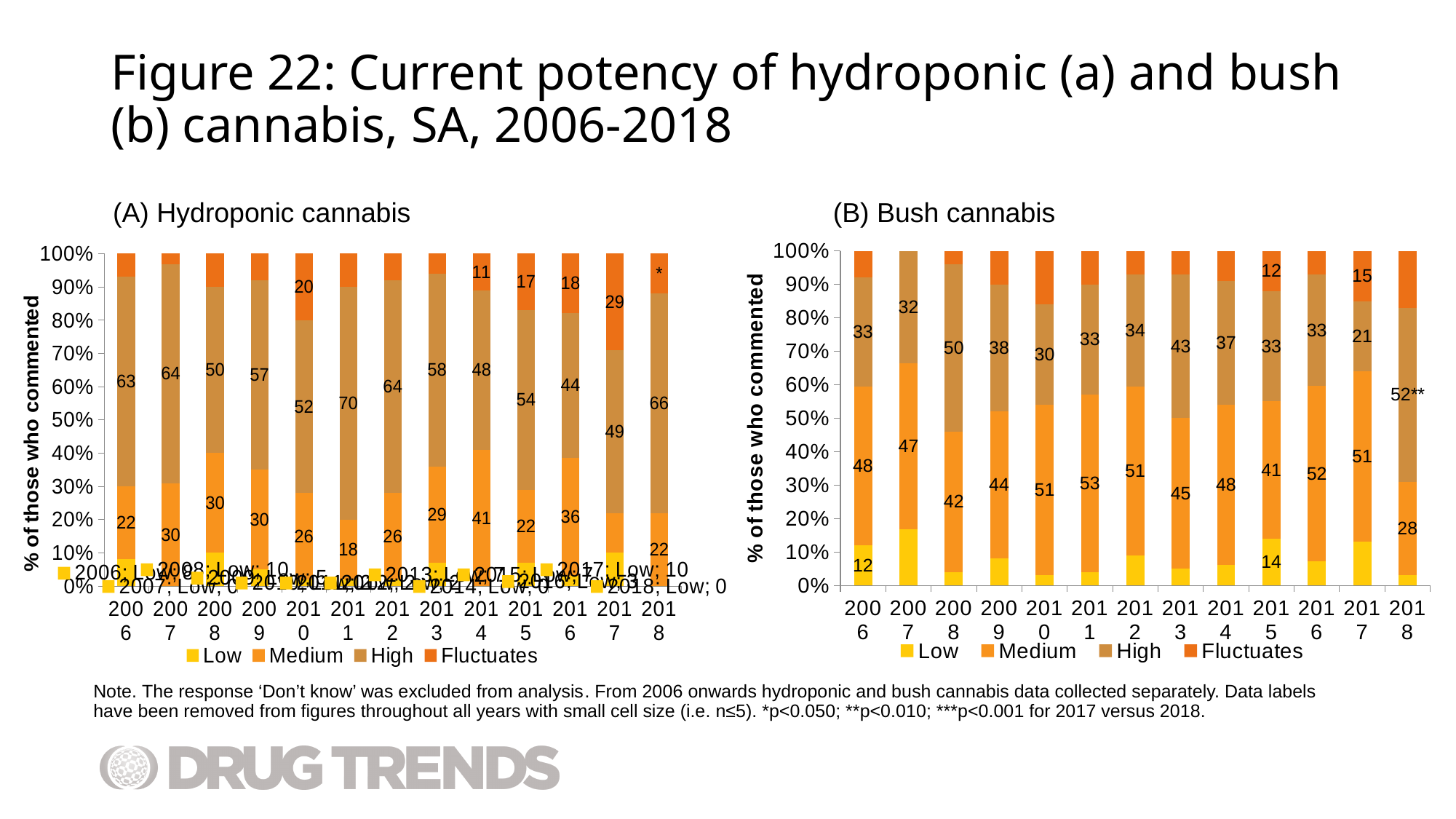
In the (B) Bush cannabis chart, what is the data label for the Low segment in 2015? 14 How many series does the legend of the (B) Bush cannabis chart list? 4 In the (B) Bush cannabis chart, which segment is larger in 2008, Medium or High? High What kind of chart is the (B) Bush cannabis chart? Stacked bar chart In the (B) Bush cannabis chart, what is the difference between the Medium segment values for 2011 and 2018? 25 In the (A) Hydroponic cannabis chart, what is the difference between the High segment values for 2011 and 2016? 26 In the (B) Bush cannabis chart, what is the data label for the Medium segment in 2018? 28 In the (A) Hydroponic cannabis chart, which year has the highest labelled value for the High segment? 2011 How many years are shown on the x axis of the (A) Hydroponic cannabis chart? 13 In the (A) Hydroponic cannabis chart, what is the data label for the High segment in 2011? 70 In the (B) Bush cannabis chart, which year has the lowest labelled value for the Medium segment? 2018 In the (A) Hydroponic cannabis chart, what is the data label for the Fluctuates segment in 2017? 29